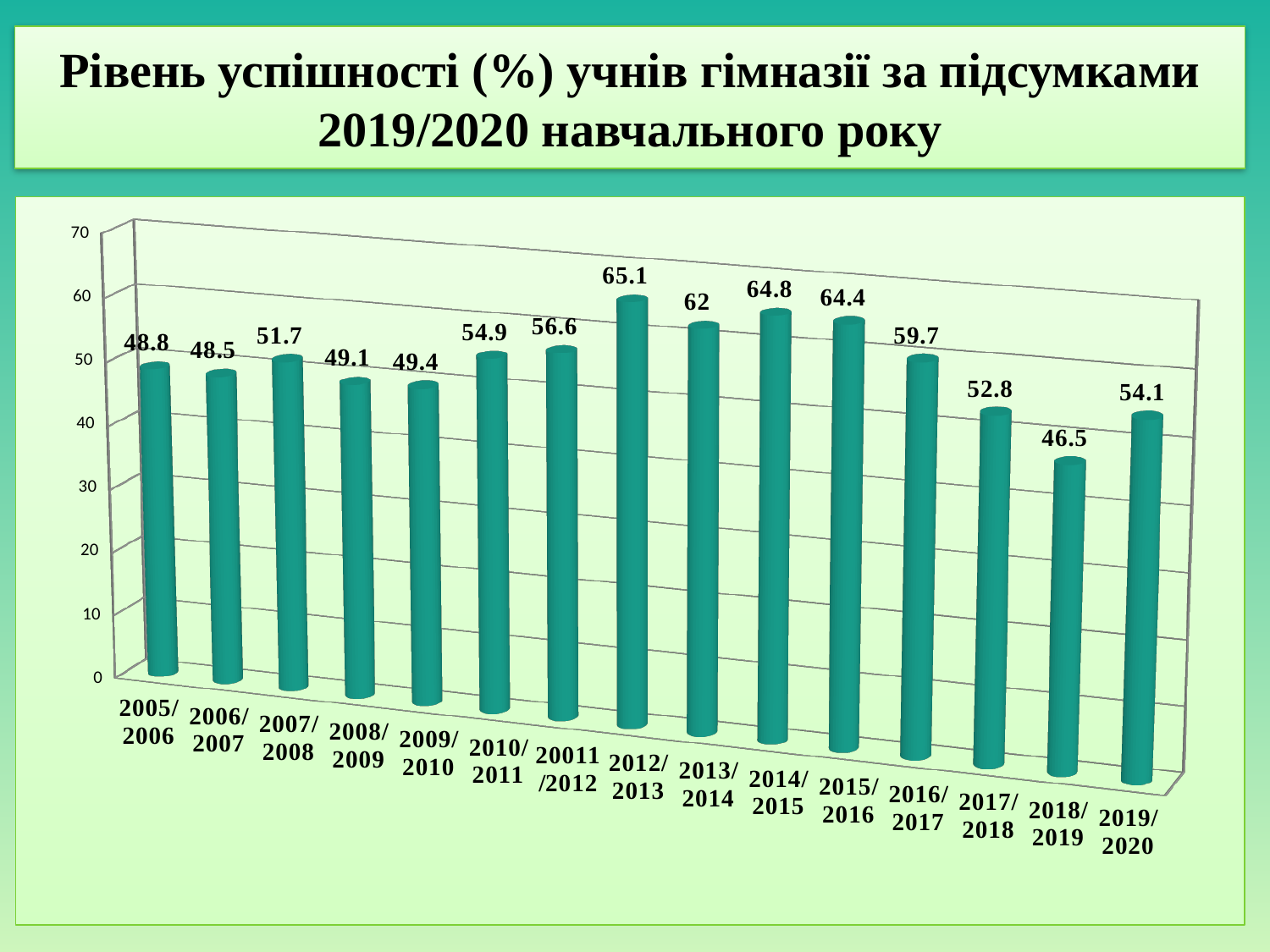
Which is larger, the value for 2014/2015 or the value for 2015/2016? 2014/2015 How many school years are shown on the chart? 15 What is the value for 2012/2013? 65.1 What kind of chart is shown on the slide? bar chart Which school year has the highest value? 2012/2013 Which is larger, the value for 2007/2008 or the value for 2008/2009? 2007/2008 Which school year has the lowest value? 2018/2019 What is the value for 2016/2017? 59.7 What is the difference between the values for 2012/2013 and 2018/2019? 18.6 What is the value for 2019/2020? 54.1 What is the difference between the values for 2019/2020 and 2018/2019? 7.6 Do the values rise or fall from 2015/2016 to 2018/2019? fall